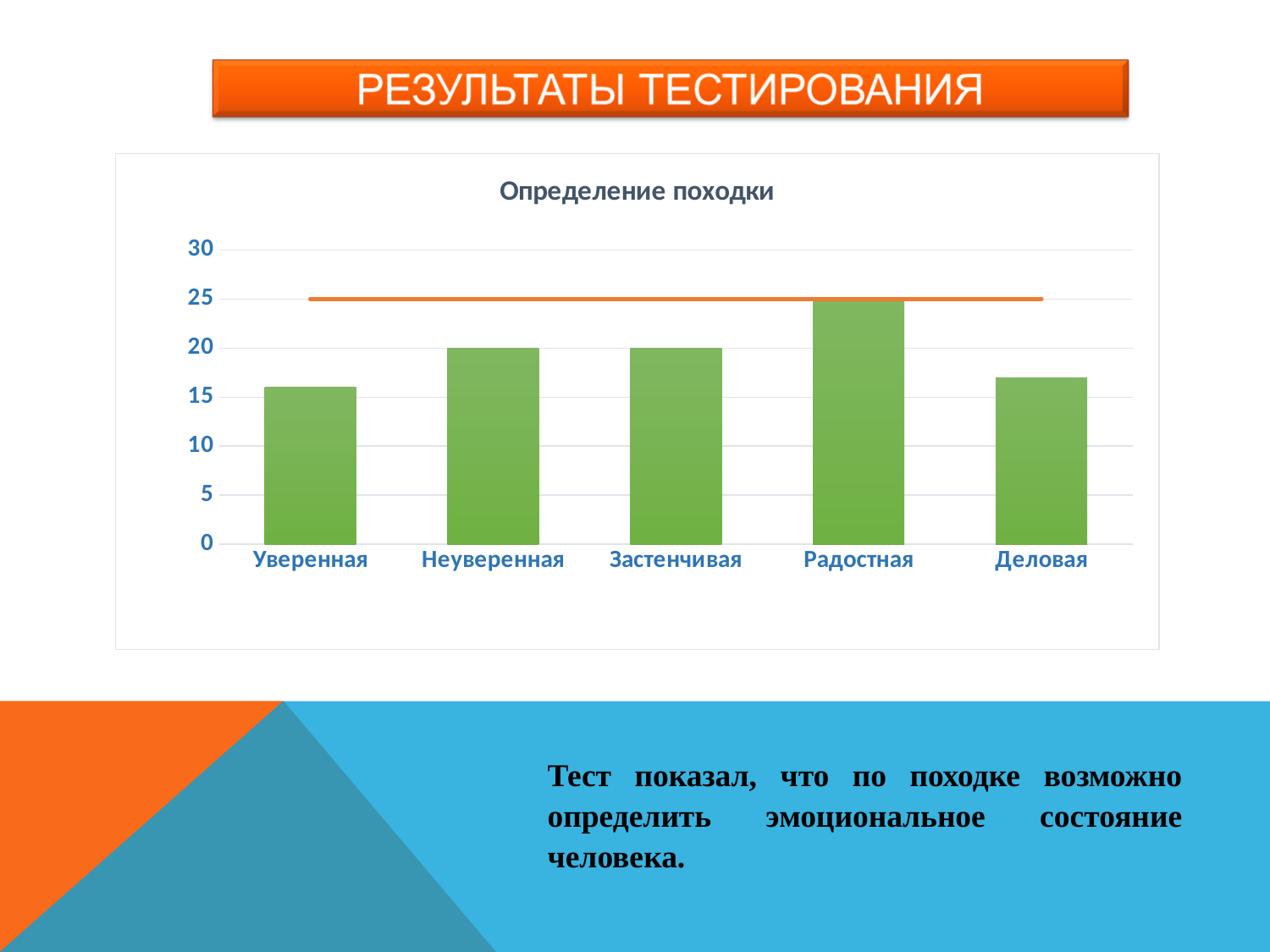
What is the value for Застенчивая? 20 Which category has the highest bar? Радостная Which is larger, the value for Радостная or the value for Деловая? Радостная What is the value for Радостная? 25 What is the difference between the values for Радостная and Неуверенная? 5 What kind of chart is shown on the slide? combination bar and line chart How many categories are shown on the x axis of the chart? 5 Is the value for Уверенная greater or less than 15? greater What is the value for Неуверенная? 20 What is the title of the chart? Определение походки Is the value for Деловая greater or less than 20? less At what value on the y axis does the orange horizontal line sit? 25